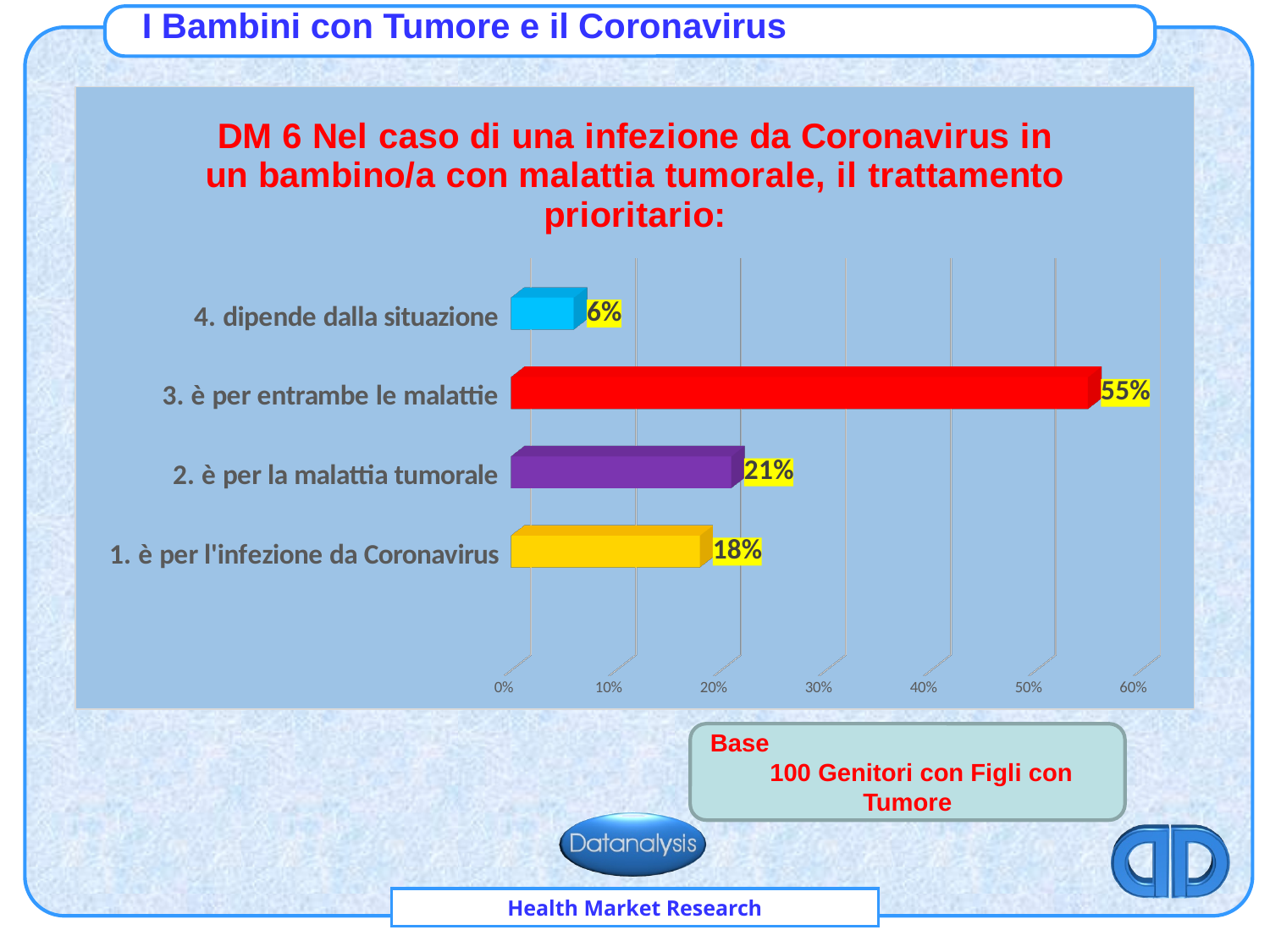
How many categories are shown in the chart? 4 Which category has the lowest value? 4. dipende dalla situazione What kind of chart is shown on the slide? bar chart What is the value for "1. è per l'infezione da Coronavirus"? 18% What is the value for "4. dipende dalla situazione"? 6% What is the difference between the values for "2. è per la malattia tumorale" and "1. è per l'infezione da Coronavirus"? 3% Which is larger: the value for "2. è per la malattia tumorale" or "1. è per l'infezione da Coronavirus"? 2. è per la malattia tumorale What is the value for "3. è per entrambe le malattie"? 55% Which category has the highest value? 3. è per entrambe le malattie Is the value for "3. è per entrambe le malattie" greater or less than 50%? greater What is the difference between the values for "3. è per entrambe le malattie" and "2. è per la malattia tumorale"? 34% What colour is the bar for "3. è per entrambe le malattie"? red